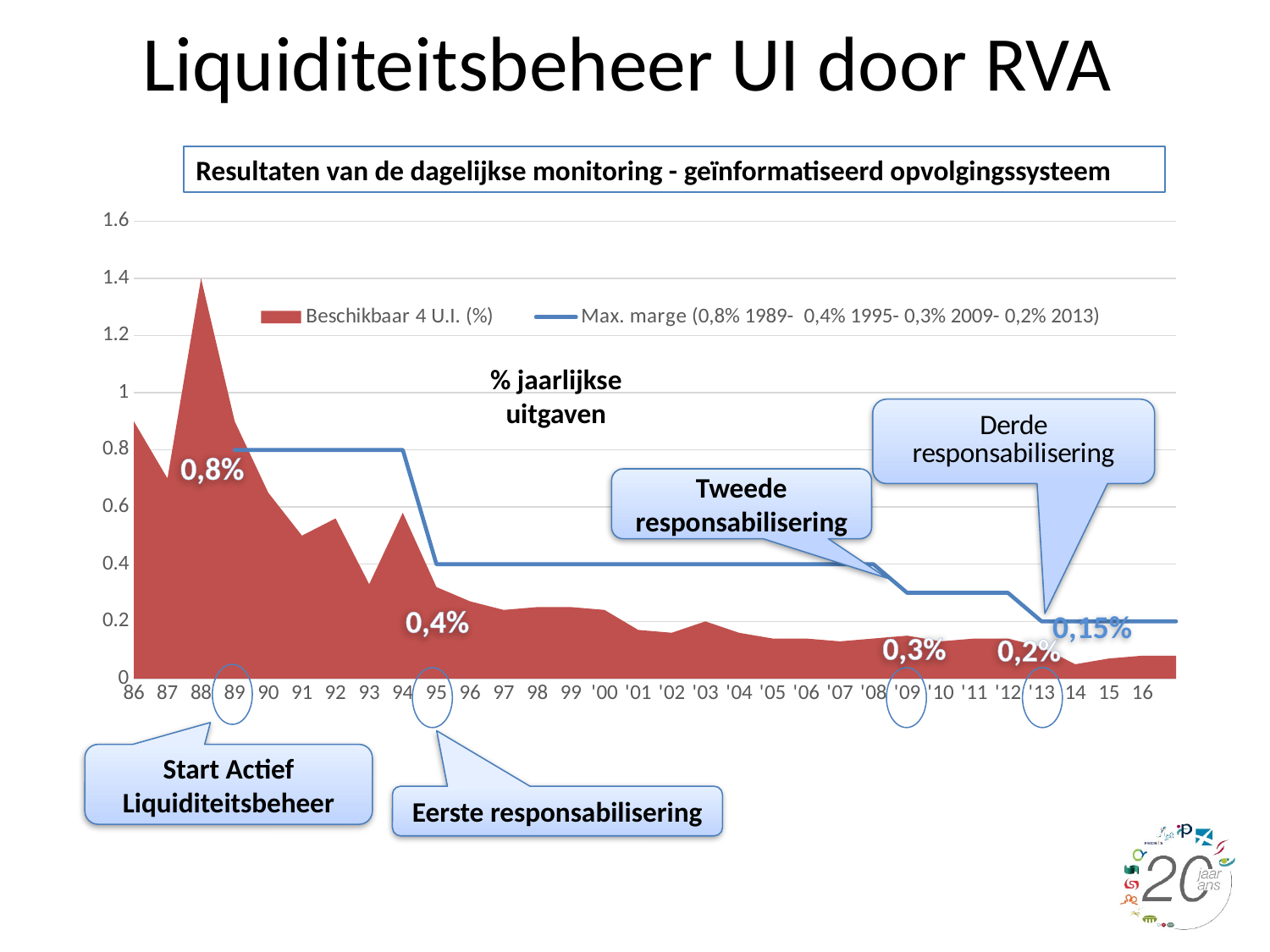
Does the 'Beschikbaar 4 U.I. (%)' series generally rise or fall from 88 to 16? fall How many years are shown along the x axis? 31 What is the title of the chart? Resultaten van de dagelijkse monitoring - geïnformatiseerd opvolgingssysteem Which year has the larger 'Beschikbaar 4 U.I. (%)' value, 88 or 94? 88 According to the legend, what is the 'Max. marge' set in 1995? 0,4% Is the 'Beschikbaar 4 U.I. (%)' value for 88 greater or less than 1.2? greater In which year is the 'Beschikbaar 4 U.I. (%)' value highest? 88 Is the 'Beschikbaar 4 U.I. (%)' value for 16 greater or less than 0.2? less How many series does the legend list? 2 Is the 'Beschikbaar 4 U.I. (%)' value for 86 greater or less than 0.8? greater What kind of chart is shown on the slide? combination area and line chart According to the legend, what is the 'Max. marge' set in 2009? 0,3%